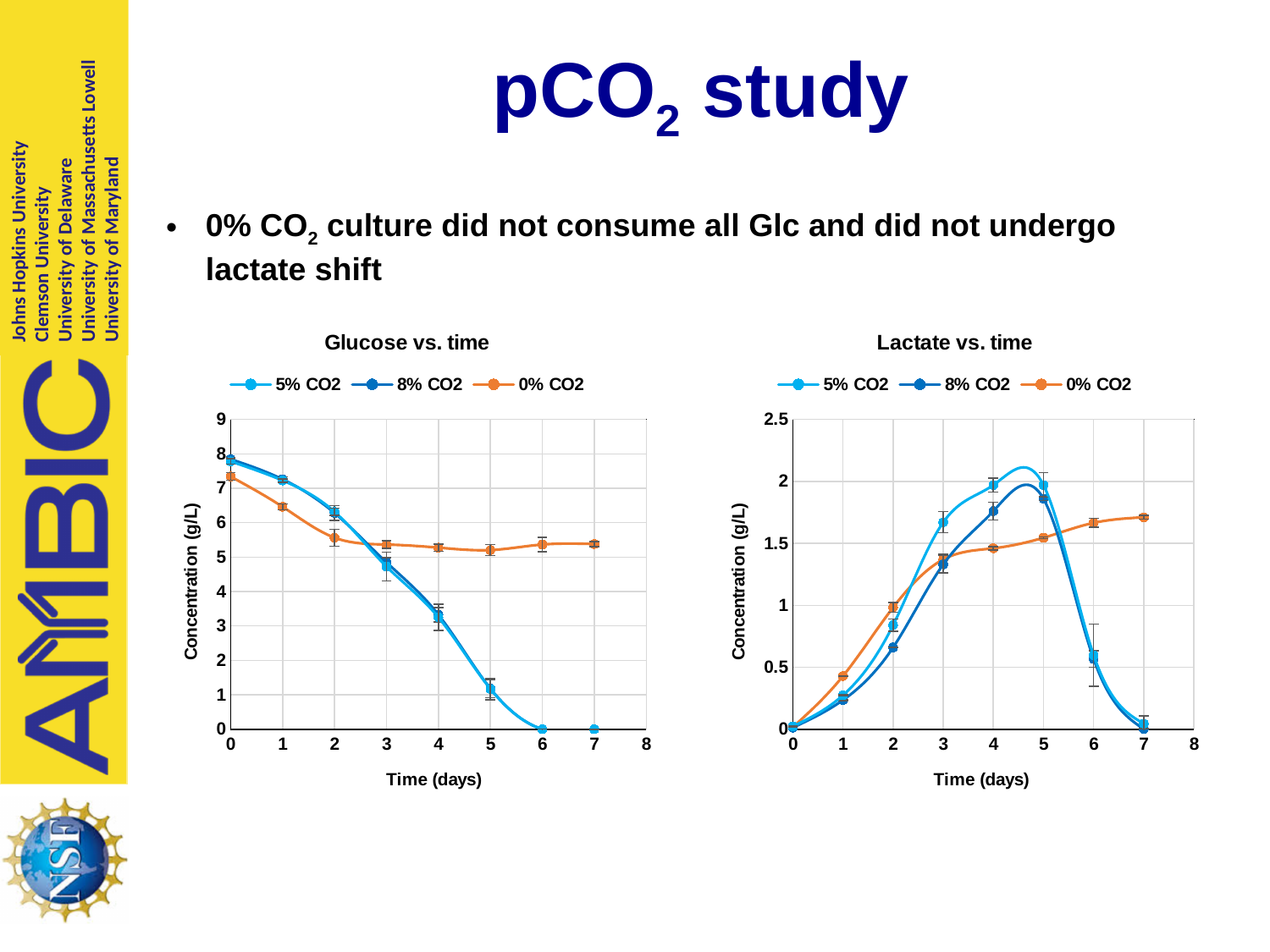
In the Glucose vs. time chart, what kind of chart is shown? line chart In the Lactate vs. time chart, is the value for 0% CO2 at day 7 greater or less than 1.5? greater In the Glucose vs. time chart, what are the three series named in the legend? 5% CO2, 8% CO2, 0% CO2 In the Glucose vs. time chart, how many series does the legend list? 3 In the Glucose vs. time chart, is the value for 5% CO2 at day 5 greater or less than 2? less In the Lactate vs. time chart, which series has the higher value at day 7, 0% CO2 or 8% CO2? 0% CO2 In the Glucose vs. time chart, what is the concentration for 5% CO2 at day 6? 0 In the Glucose vs. time chart, is the value for 0% CO2 at day 7 greater or less than 5? greater In the Lactate vs. time chart, what is the x-axis label? Time (days) In the Lactate vs. time chart, how many series does the legend list? 3 In the Glucose vs. time chart, which series has the higher value at day 7, 0% CO2 or 5% CO2? 0% CO2 In the Glucose vs. time chart, does the 5% CO2 series rise or fall over time? fall